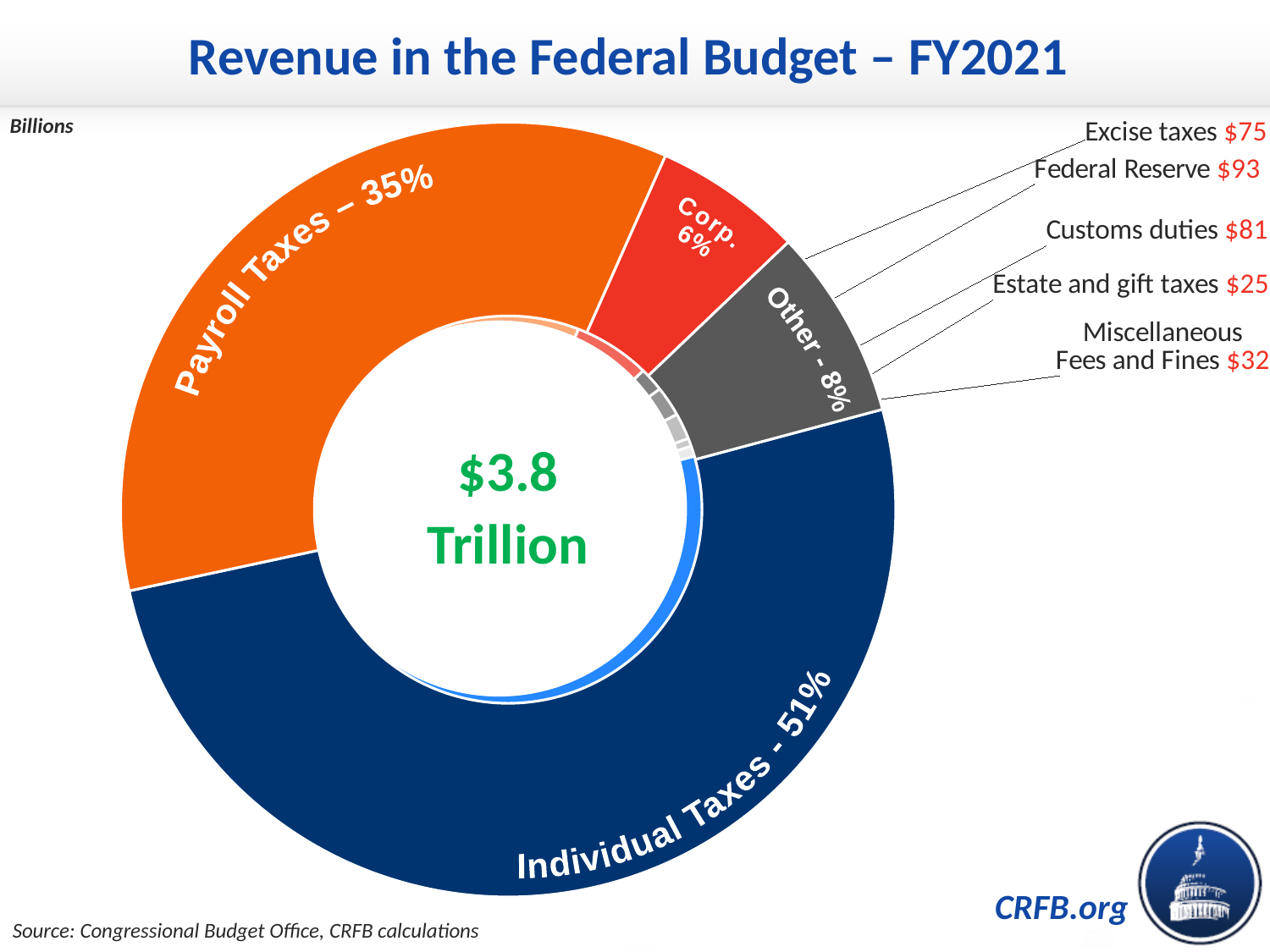
What is the total revenue shown in the centre of the chart? $3.8 Trillion What is the difference in percentage points between Individual Taxes and Payroll Taxes? 16 How much revenue comes from the Federal Reserve, in billions? $93 Which is larger: Excise taxes or Customs duties? Customs duties Which of the four main revenue categories has the smallest share? Corp. Which revenue category has the largest share of the donut? Individual Taxes What share of federal revenue is labelled Other? 8% What kind of chart is shown on the slide? Pie (donut) chart What share of federal revenue is labelled Corp.? 6% What share of federal revenue comes from Payroll Taxes? 35% How much revenue comes from Estate and gift taxes, in billions? $25